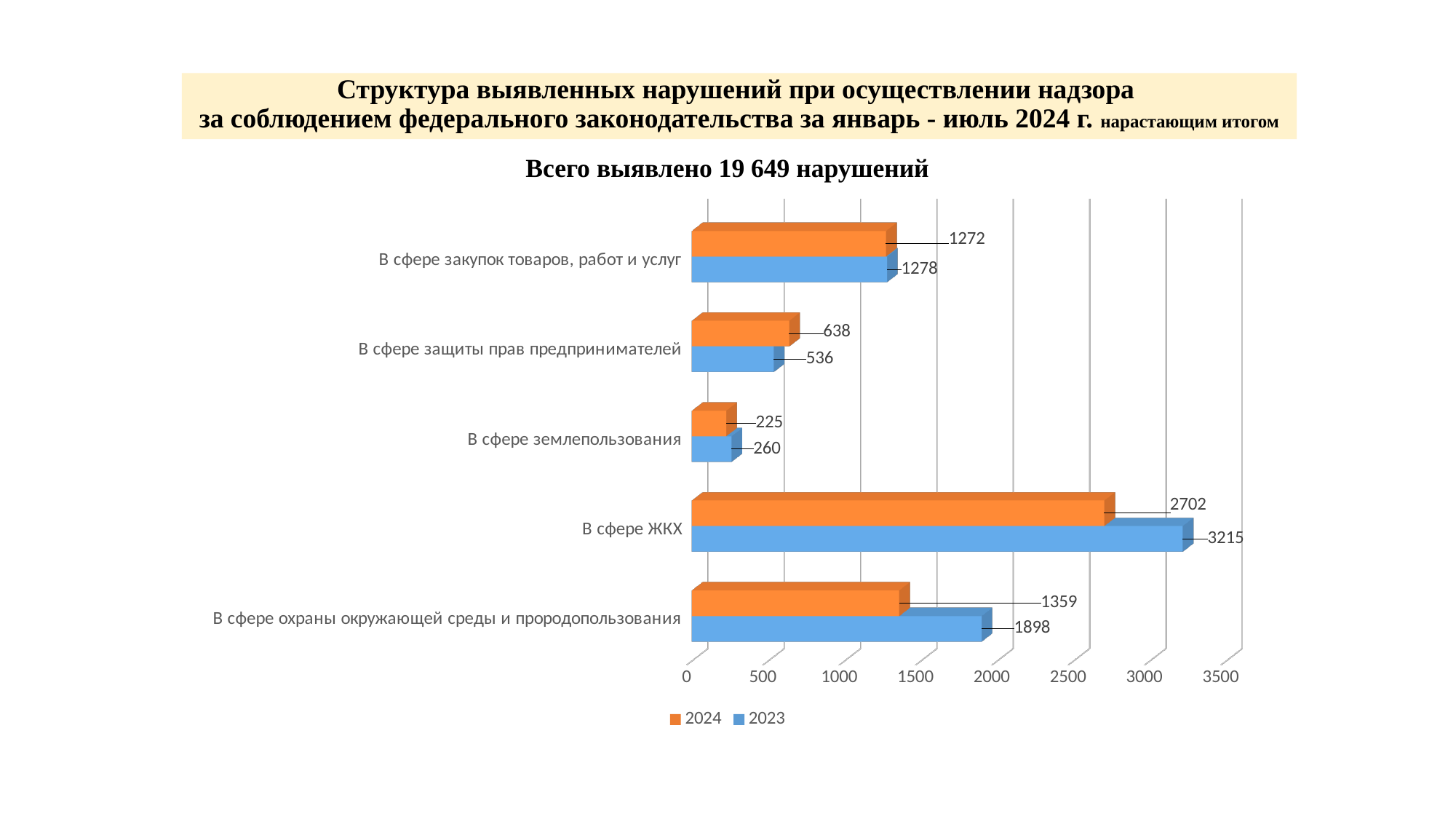
What is the 2024 value for В сфере защиты прав предпринимателей? 638 Which is larger for В сфере защиты прав предпринимателей: the 2024 value or the 2023 value? 2024 What is the 2023 value for В сфере землепользования? 260 What total number of violations is stated above the chart? 19 649 What is the difference between the 2023 and 2024 values for В сфере ЖКХ? 513 Which category has the lowest 2024 value? В сфере землепользования What is the 2024 value for В сфере ЖКХ? 2702 What kind of chart is shown on the slide? Bar chart Which category has the highest 2023 value? В сфере ЖКХ How many series does the legend list? 2 What is the 2023 value for В сфере охраны окружающей среды и прородопользования? 1898 How many categories are shown on the chart? 5